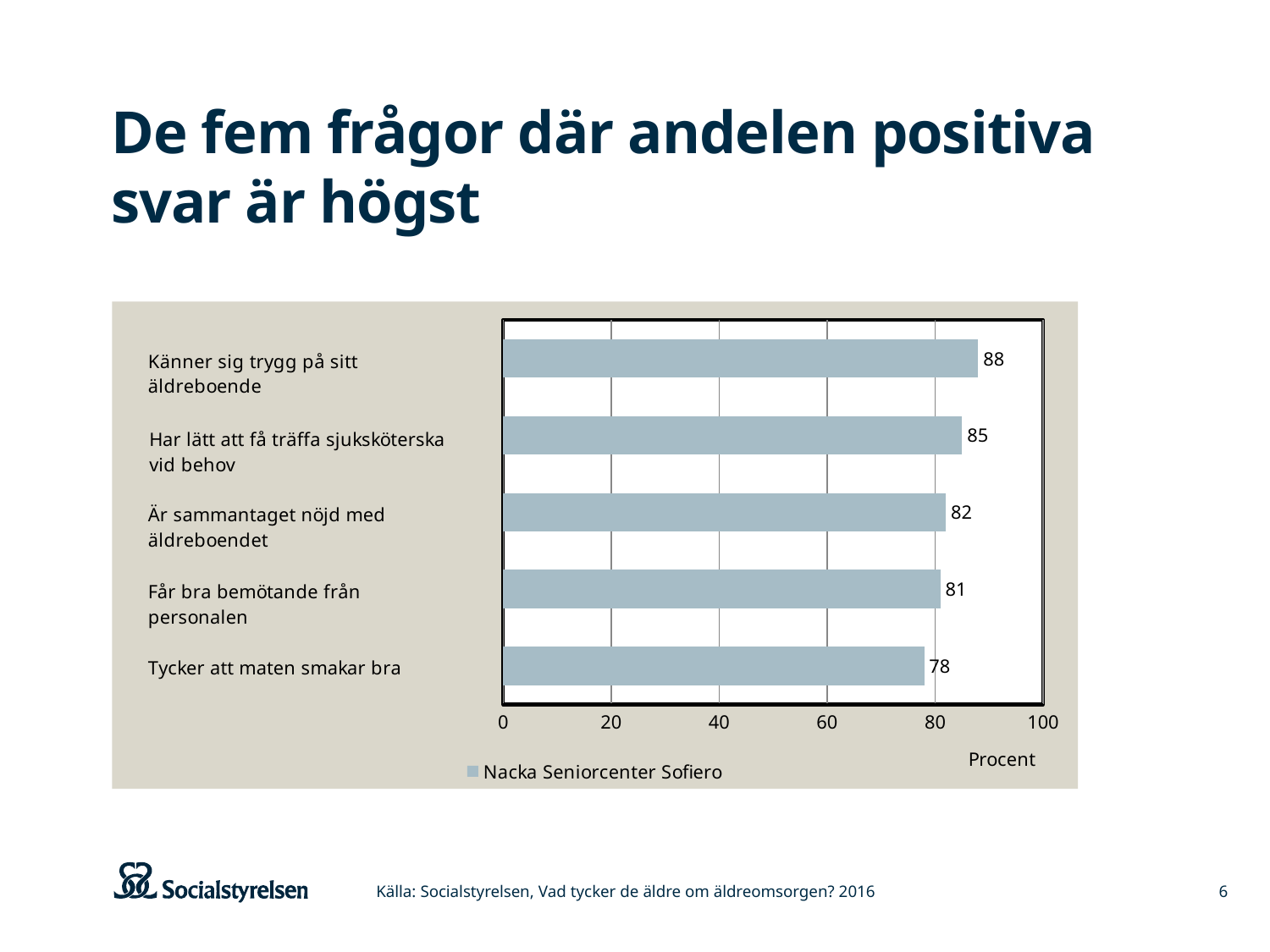
How many categories are shown in the chart? 5 What is the value for "Känner sig trygg på sitt äldreboende"? 88 What is the difference between the values for "Har lätt att få träffa sjuksköterska vid behov" and "Får bra bemötande från personalen"? 4 What is the name of the series shown in the legend? Nacka Seniorcenter Sofiero How many series does the legend list? 1 What kind of chart is shown on the slide? bar chart Which category has the highest value? Känner sig trygg på sitt äldreboende Is the value for "Tycker att maten smakar bra" greater or less than 80? less What is the value for "Är sammantaget nöjd med äldreboendet"? 82 What is the value for "Tycker att maten smakar bra"? 78 Which category has the lowest value? Tycker att maten smakar bra Which is larger: the value for "Har lätt att få träffa sjuksköterska vid behov" or the value for "Tycker att maten smakar bra"? Har lätt att få träffa sjuksköterska vid behov